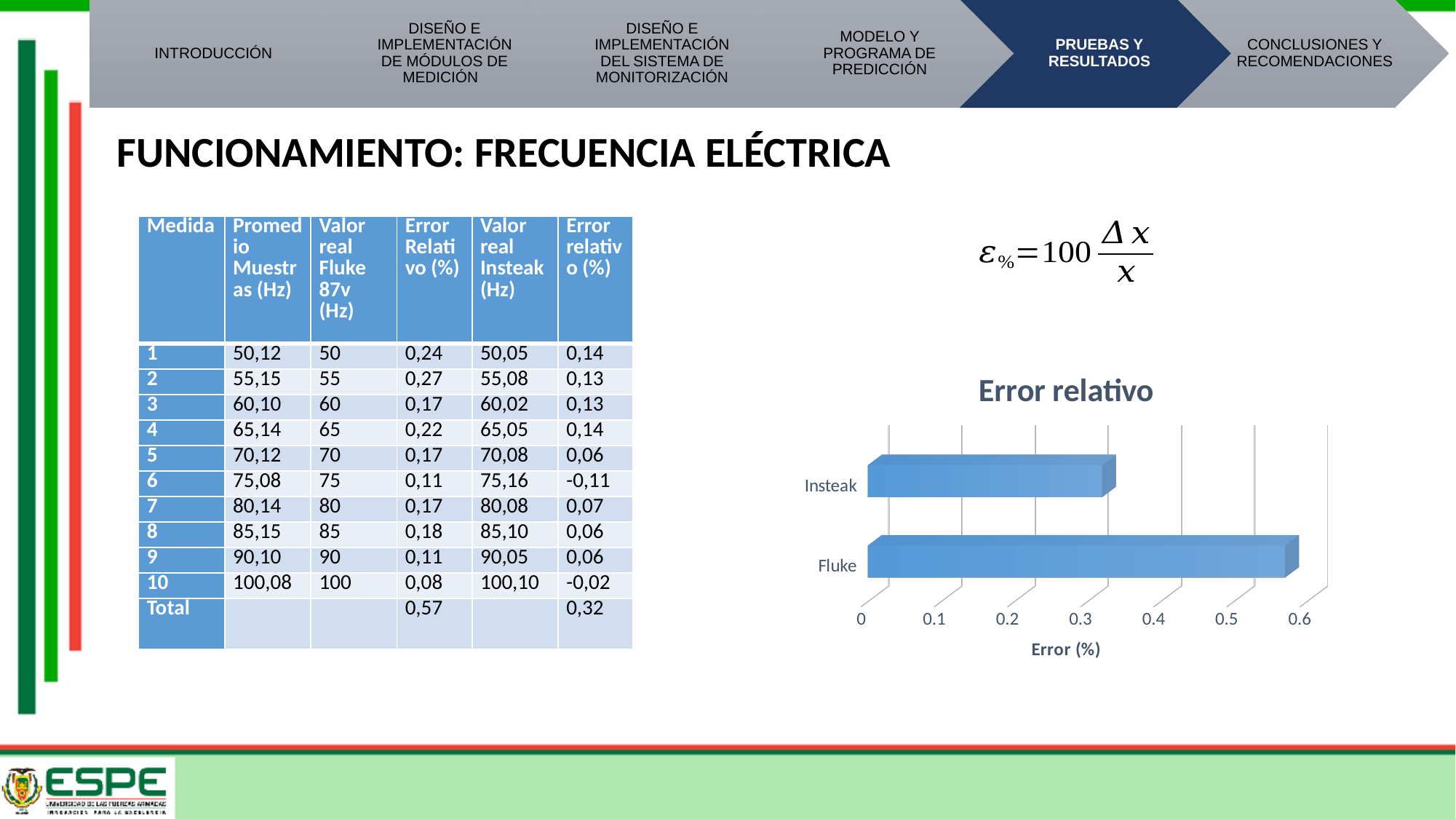
What is the title of the chart on the slide? Error relativo What is the label of the horizontal axis in the "Error relativo" chart? Error (%) In the "Error relativo" chart, is the value for Insteak greater or less than 0.4? less In the "Error relativo" chart, is the value for Fluke greater or less than 0.6? less What kind of chart is shown under the title "Error relativo"? bar chart In the "Error relativo" chart, which category has the highest value? Fluke How many categories are plotted in the "Error relativo" chart? 2 In the "Error relativo" chart, which is larger, the value for Fluke or the value for Insteak? Fluke In the "Error relativo" chart, is the value for Fluke greater or less than 0.5? greater In the "Error relativo" chart, which category has the lowest value? Insteak